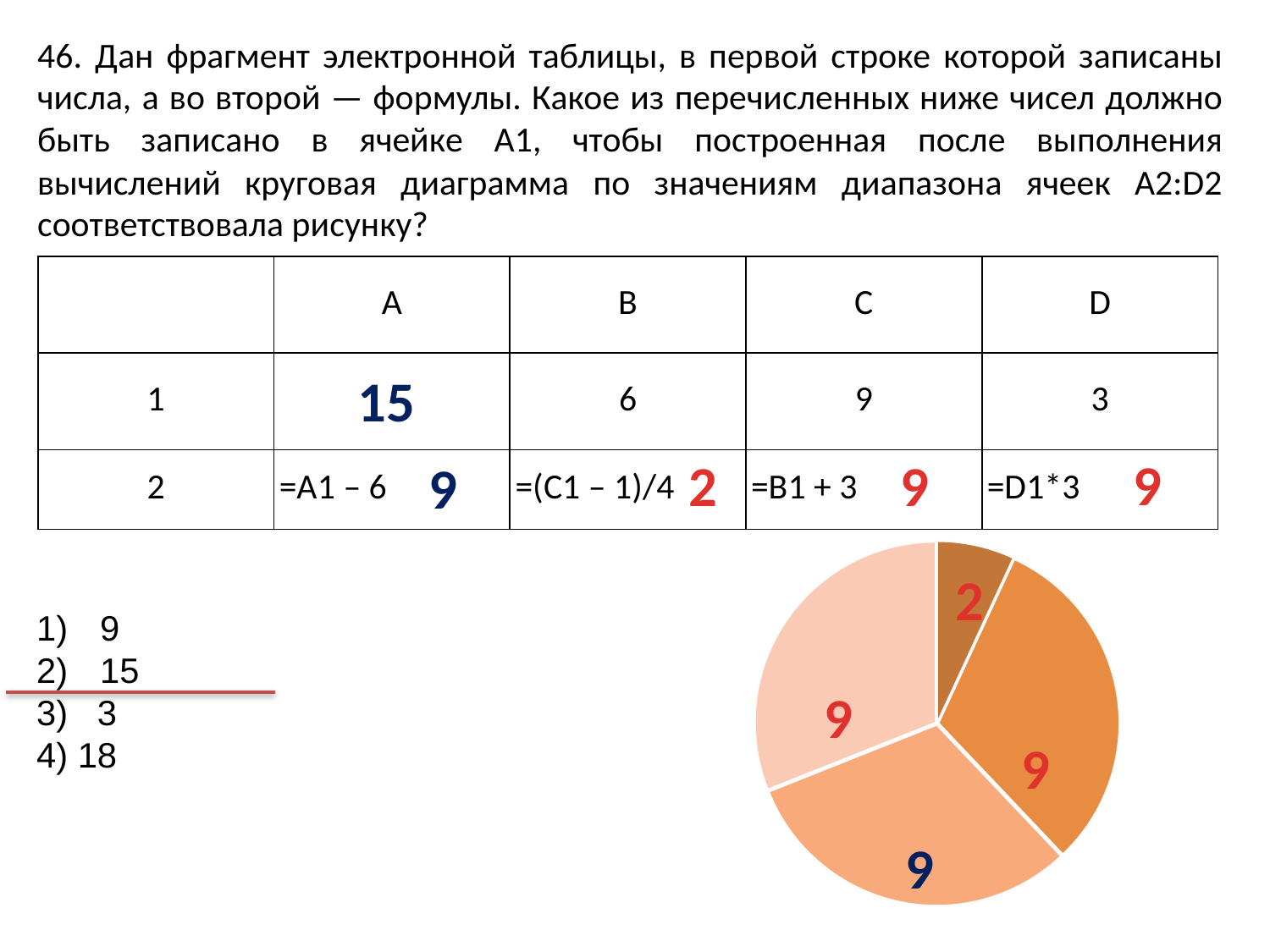
What kind of chart is shown on the slide? pie chart Which is larger: the slice labelled 2 or any of the slices labelled 9? the slice labelled 9 What is the value of the smallest slice in the pie chart? 2 How many slices does the pie chart have? 4 What is the largest value labelled on a slice of the pie chart? 9 Does the pie chart have a legend? no Is the value of the smallest slice greater or less than 5? less How many slices of the pie chart are labelled 9? 3 What is the total of all the slice values in the pie chart? 29 Which slice of the pie chart is the darkest in colour? the slice labelled 2 What is the difference between a slice labelled 9 and the slice labelled 2? 7